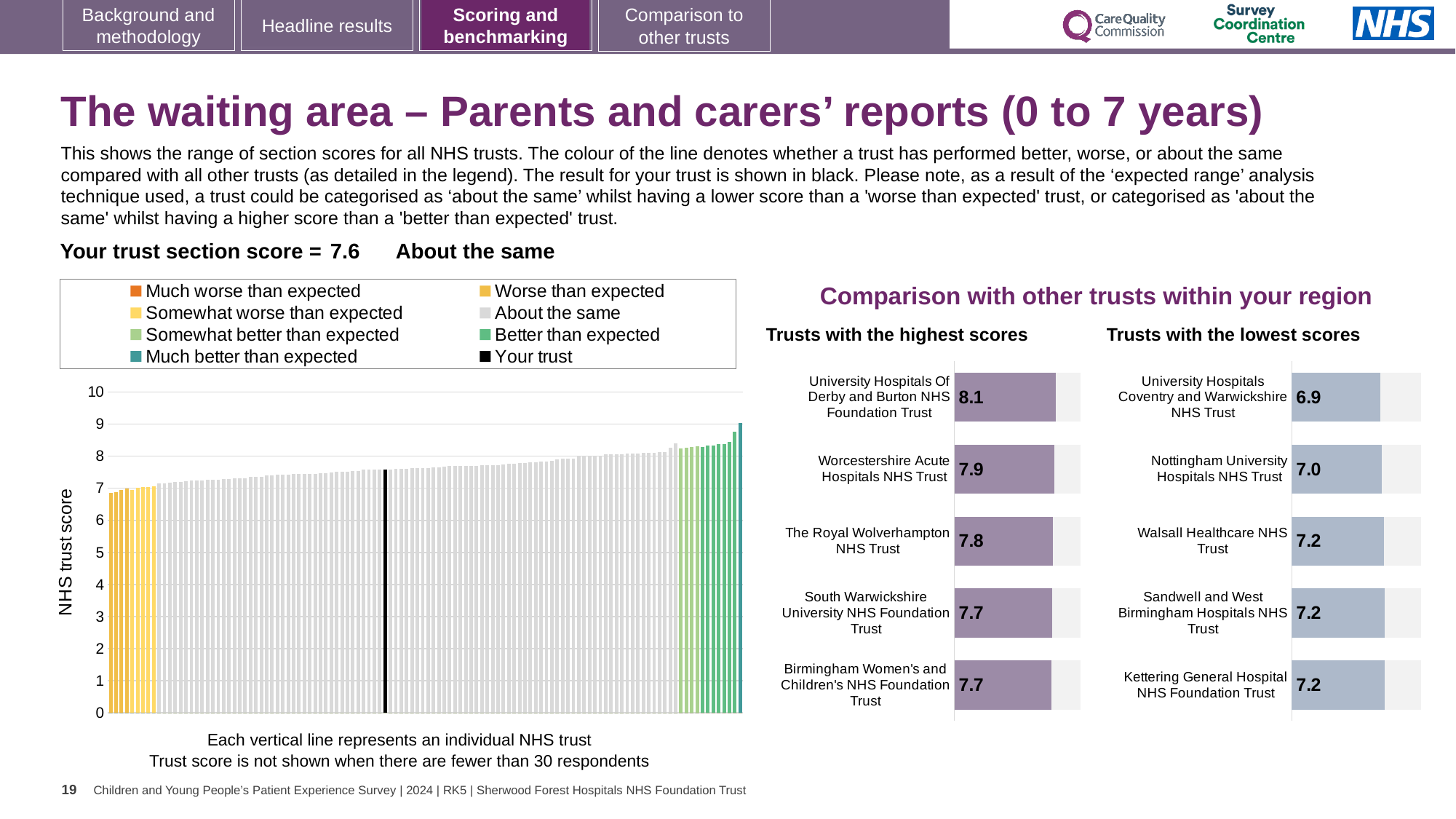
In the 'Trusts with the lowest scores' chart, what is the score for University Hospitals Coventry and Warwickshire NHS Trust? 6.9 In the 'Trusts with the highest scores' chart, which trust has the highest score? University Hospitals Of Derby and Burton NHS Foundation Trust How many entries does the legend of the 'NHS trust score' chart list? 8 In the 'NHS trust score' chart on the left, is the tallest bar greater or less than 8? greater In the 'Trusts with the highest scores' chart, what is the score for University Hospitals Of Derby and Burton NHS Foundation Trust? 8.1 In the 'Trusts with the lowest scores' chart, what is the difference between the scores of Walsall Healthcare NHS Trust and University Hospitals Coventry and Warwickshire NHS Trust? 0.3 In the 'NHS trust score' chart on the left, is the value of the black bar (your trust) greater or less than 7? greater What kind of chart is the 'NHS trust score' chart on the left? bar chart How many trusts are shown in the 'Trusts with the highest scores' chart? 5 In the 'Trusts with the lowest scores' chart, which has the higher score: Nottingham University Hospitals NHS Trust or Walsall Healthcare NHS Trust? Walsall Healthcare NHS Trust In the 'Trusts with the highest scores' chart, what is the difference between the scores of University Hospitals Of Derby and Burton NHS Foundation Trust and Worcestershire Acute Hospitals NHS Trust? 0.2 In the 'Trusts with the lowest scores' chart, which trust has the lowest score? University Hospitals Coventry and Warwickshire NHS Trust